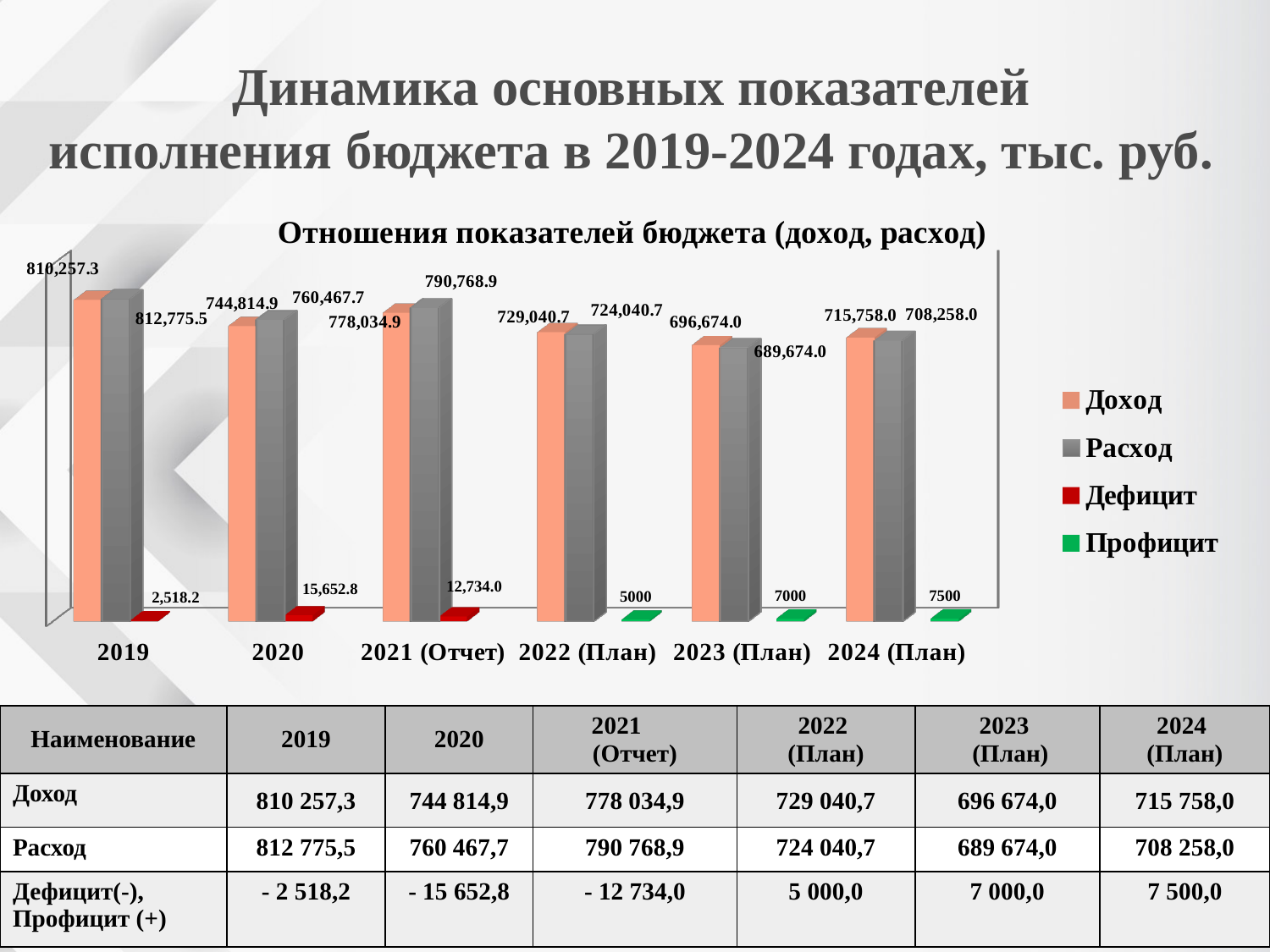
In which year is Доход the highest? 2019 What is the Дефицит value shown for 2020? 15,652.8 What is the value of Доход for 2019 in the chart? 810,257.3 Does the Профицит value rise or fall from 2022 (План) to 2024 (План)? Rise In which year is Доход the lowest? 2023 (План) How many series does the chart legend list? 4 What is the difference between Расход and Доход in 2020? 15,652.8 Which is larger in 2022 (План): Доход or Расход? Доход What type of chart is shown on the slide? Bar chart What is the value of Расход for 2021 (Отчет) in the chart? 790,768.9 How many year categories are shown on the x axis of the chart? 6 What is the Профицит value shown for 2024 (План)? 7500